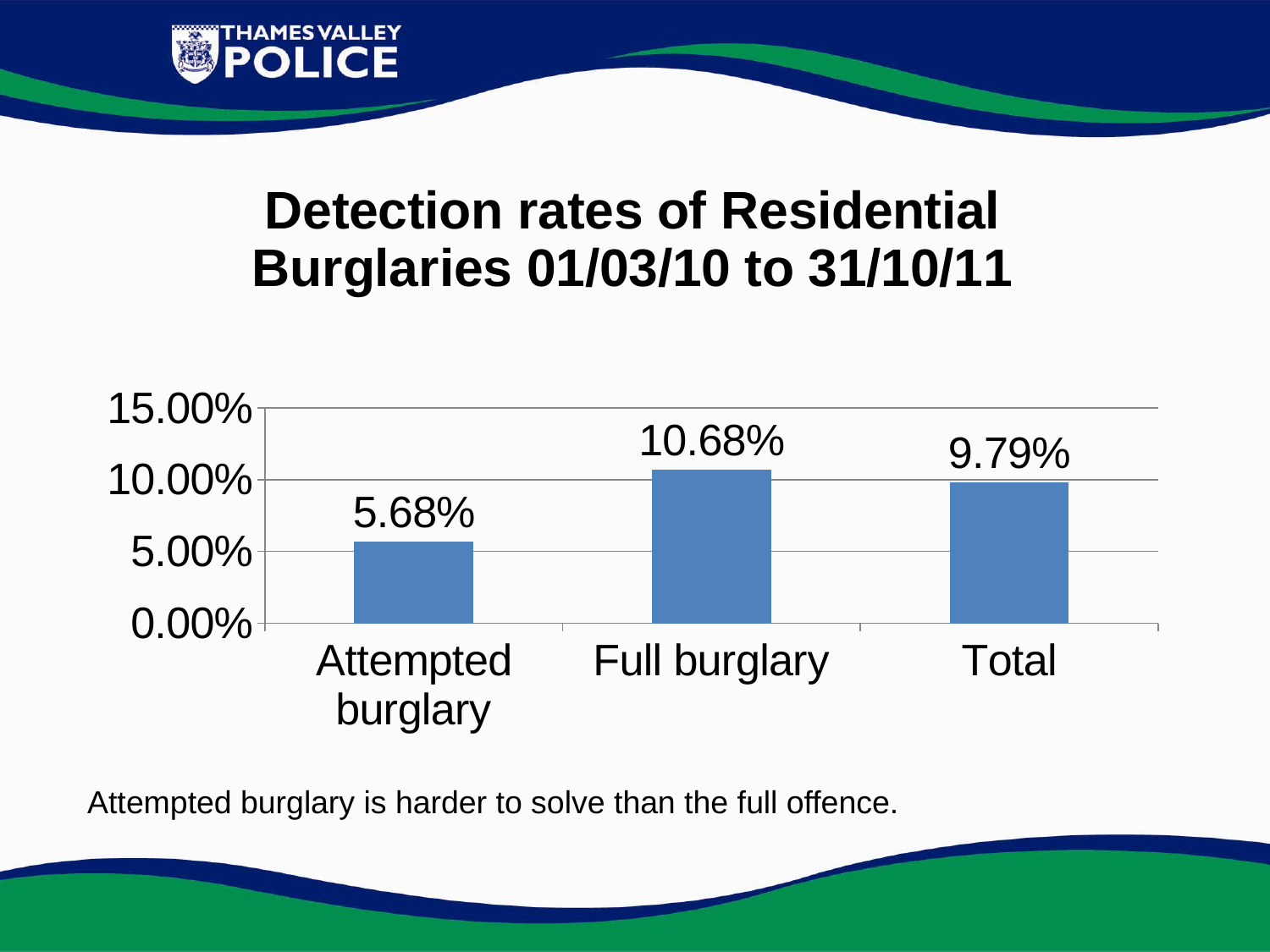
Is the detection rate for Full burglary greater or less than 10.00%? greater Which is larger, the detection rate for Attempted burglary or for Total? Total What is the difference between the detection rates for Full burglary and Attempted burglary? 5.00% What is the detection rate for Attempted burglary? 5.68% What is the difference between the detection rates for Full burglary and Total? 0.89% What kind of chart is shown on the slide? Bar chart What is the detection rate for Full burglary? 10.68% What is the title of the chart? Detection rates of Residential Burglaries 01/03/10 to 31/10/11 What is the detection rate for Total? 9.79% Which category has the lowest detection rate? Attempted burglary Which category has the highest detection rate? Full burglary How many categories are shown in the chart? 3